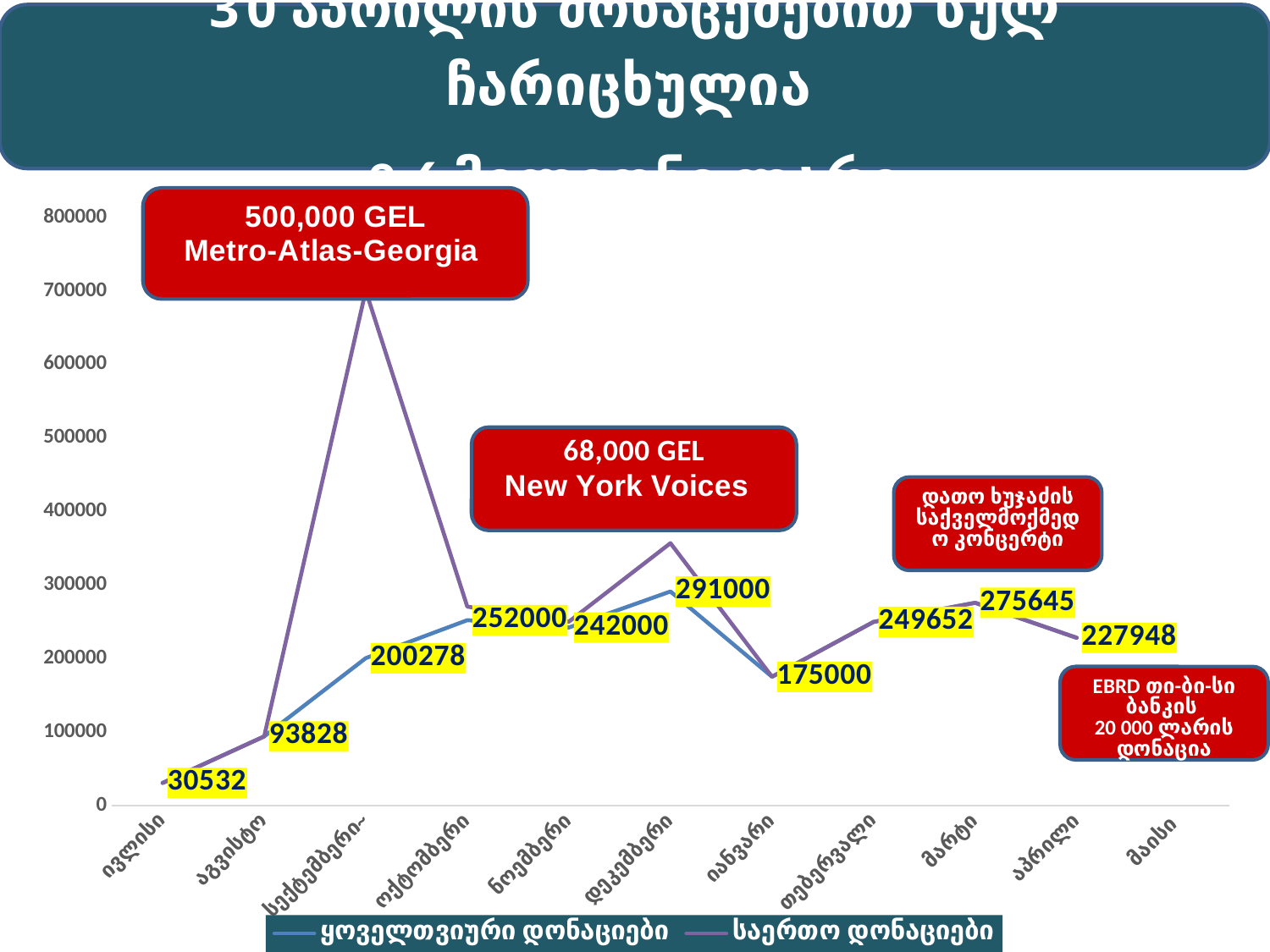
How many series does the chart legend list? 2 Which month has the lowest labeled value? ივლისი Which has the larger labeled value, მარტი or აპრილი? მარტი How many month categories are shown along the x axis? 11 What is the labeled value for დეკემბერი? 291000 What is the labeled value for ოქტომბერი? 252000 What is the difference between the labeled values for დეკემბერი and იანვარი? 116000 Is the value of the საერთო დონაციები series in სექტემბერი greater or less than 600000? greater Do the labeled values rise or fall from ივლისი to ოქტომბერი? rise What kind of chart is shown on the slide? line chart In which month does the საერთო დონაციები series reach its highest point? სექტემბერი What is the labeled value for თებერვალი? 249652